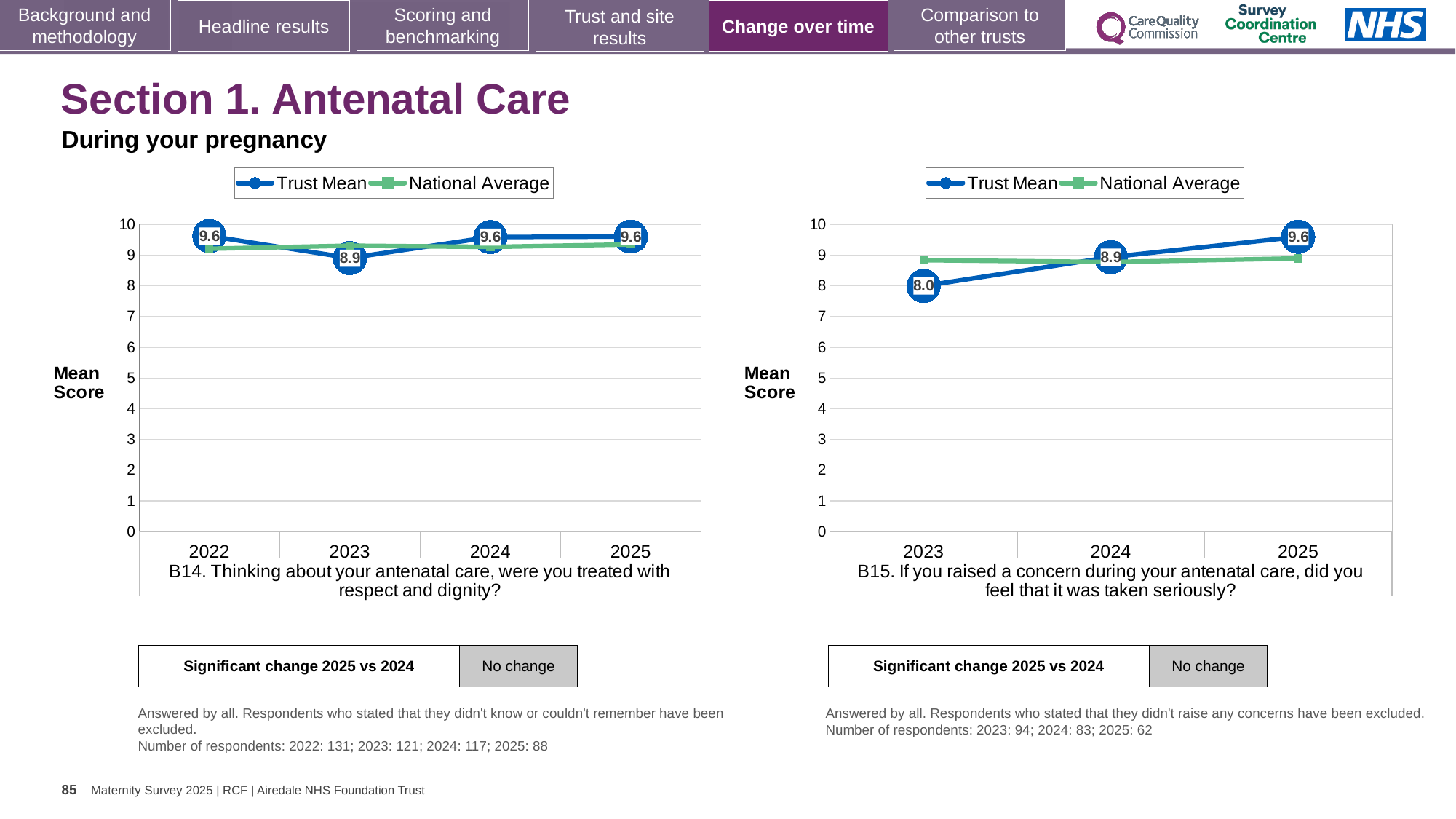
How many series does the legend of the B14 chart (left) list? 2 In the B15 chart (right), what is the Trust Mean for 2023? 8.0 In the B14 chart (left), what is the difference between the Trust Mean for 2022 and 2023? 0.7 In the B15 chart (right), what is the Trust Mean for 2025? 9.6 In the B14 chart (left), how many years are plotted on the x axis? 4 In the B14 chart (left), what is the Trust Mean for 2025? 9.6 In the B14 chart (left), which year has the lowest Trust Mean? 2023 In the B15 chart (right), does the Trust Mean rise or fall from 2023 to 2025? rise In the B15 chart (right), what is the difference between the Trust Mean for 2025 and 2023? 1.6 In the B15 chart (right), is the Trust Mean for 2023 larger or smaller than the Trust Mean for 2024? smaller In the B14 chart (left), what is the Trust Mean for 2023? 8.9 In the B15 chart (right), is the National Average for 2023 greater or less than 8? greater